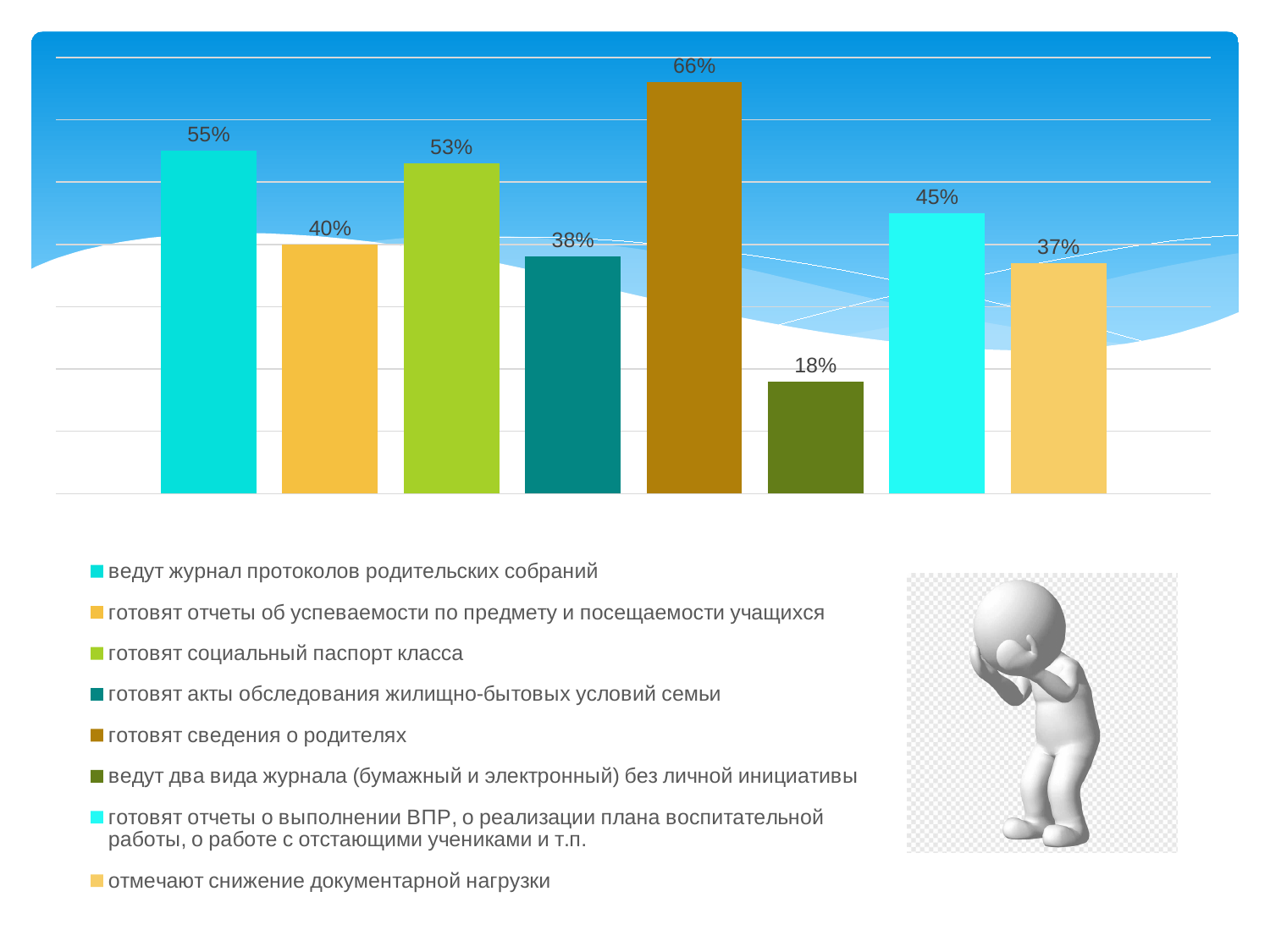
Which is larger: the value for "готовят социальный паспорт класса" or the value for "готовят отчеты об успеваемости по предмету и посещаемости учащихся"? готовят социальный паспорт класса How many bars are plotted on the chart? 8 What value is shown for "готовят акты обследования жилищно-бытовых условий семьи"? 38% What value is shown for "готовят сведения о родителях"? 66% Which legend entry has the lowest value? ведут два вида журнала (бумажный и электронный) без личной инициативы What colour is the bar for "готовят сведения о родителях"? brown What kind of chart is shown on the slide? bar chart How many entries does the legend list? 8 What is the difference between the values for "готовят сведения о родителях" and "ведут два вида журнала (бумажный и электронный) без личной инициативы"? 48% What value is shown for "отмечают снижение документарной нагрузки"? 37% What value is shown for "ведут журнал протоколов родительских собраний"? 55% Which legend entry has the highest value? готовят сведения о родителях